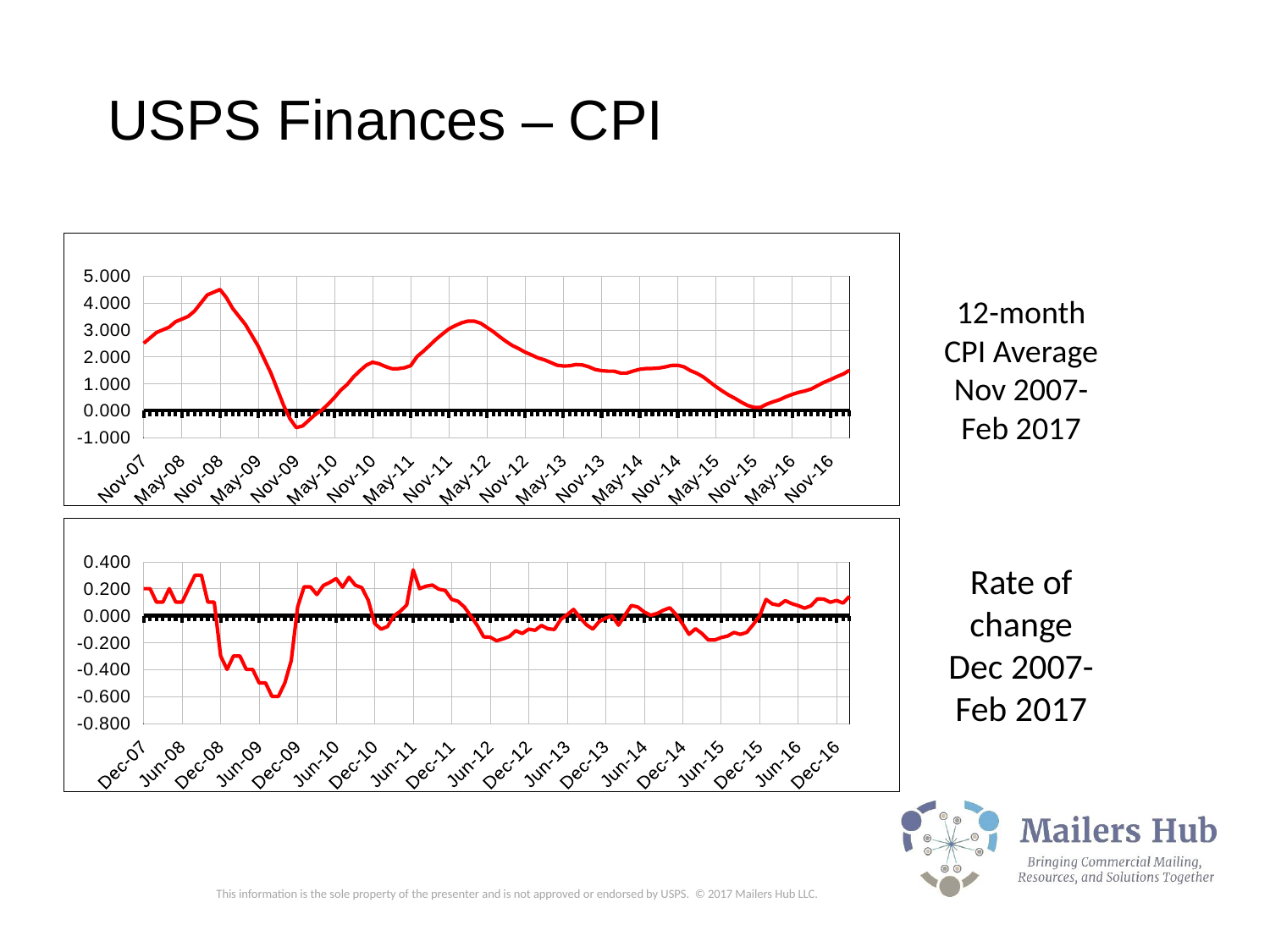
In the top chart (12-month CPI Average), is the value at Nov-09 greater or less than 0.000? less In the top chart (12-month CPI Average), is the value at Nov-08 greater or less than 4.000? greater In the top chart (12-month CPI Average), does the line rise or fall between Nov-08 and Nov-09? Falls What period does the top chart's caption say the 12-month CPI Average covers? Nov 2007-Feb 2017 In the bottom chart (Rate of change), is the value at Jun-11 greater or less than 0.200? greater In the top chart (12-month CPI Average), does the line rise or fall between Nov-09 and Nov-10? Rises What kind of chart is the top chart on the slide? Line chart What kind of chart is the bottom chart on the slide? Line chart